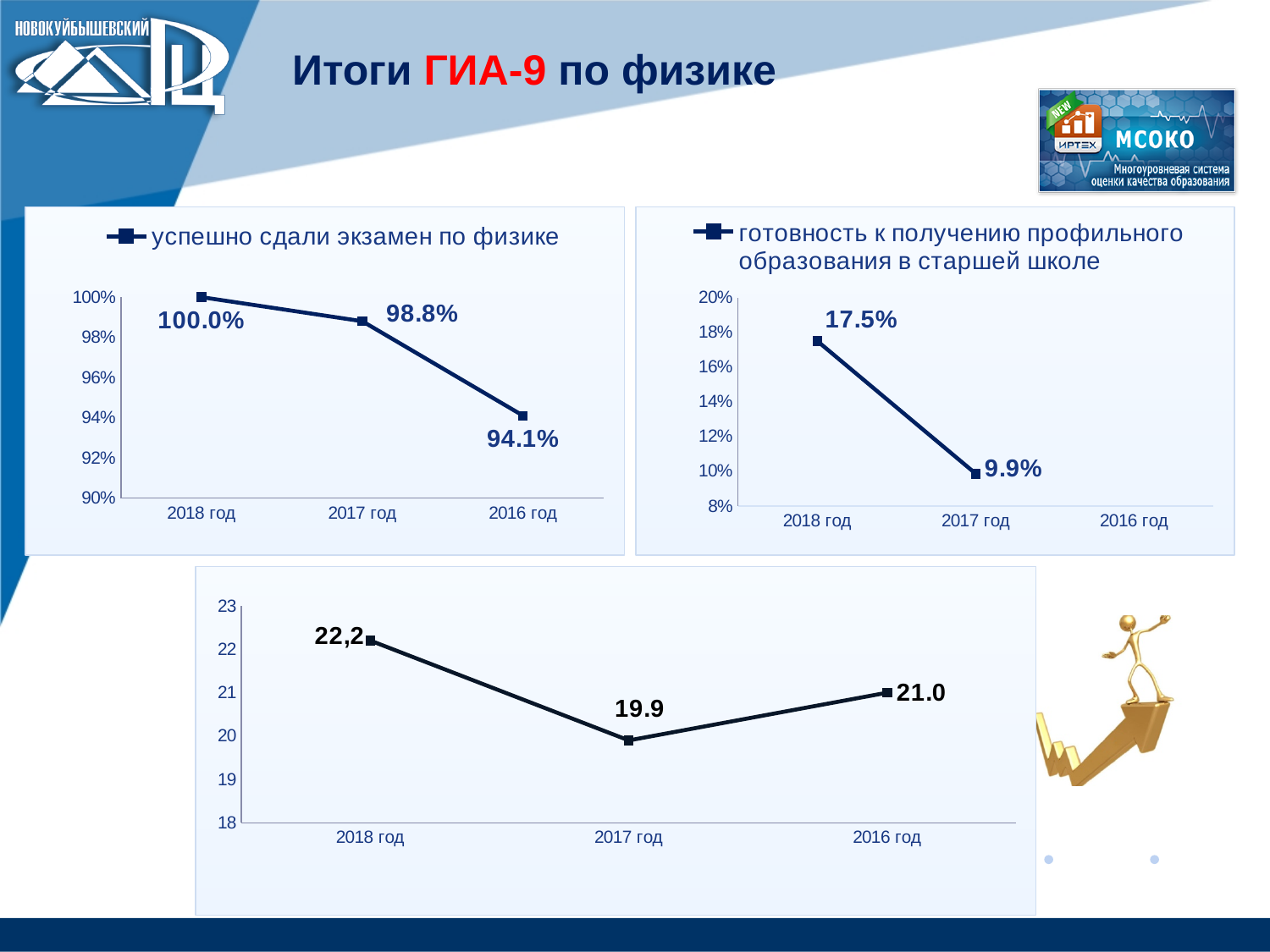
In the top-right chart 'готовность к получению профильного образования в старшей школе', how many data points are plotted? 2 In the top-right chart 'готовность к получению профильного образования в старшей школе', what is the value for 2017 год? 9.9% In the top-left chart 'успешно сдали экзамен по физике', what is the value for 2017 год? 98.8% In the top-left chart 'успешно сдали экзамен по физике', which year has the lowest value? 2016 год In the top-left chart 'успешно сдали экзамен по физике', what is the difference between the values for 2018 год and 2016 год? 5.9% In the bottom chart, what is the difference between the values for 2016 год and 2017 год? 1.1 In the bottom chart, which year has the highest value? 2018 год In the bottom chart, what is the value for 2017 год? 19.9 In the bottom chart, how many categories are shown on the x axis? 3 In the top-right chart 'готовность к получению профильного образования в старшей школе', what is the value for 2018 год? 17.5% What kind of chart is the top-left chart 'успешно сдали экзамен по физике'? line chart In the top-right chart 'готовность к получению профильного образования в старшей школе', which is larger, the value for 2018 год or 2017 год? 2018 год